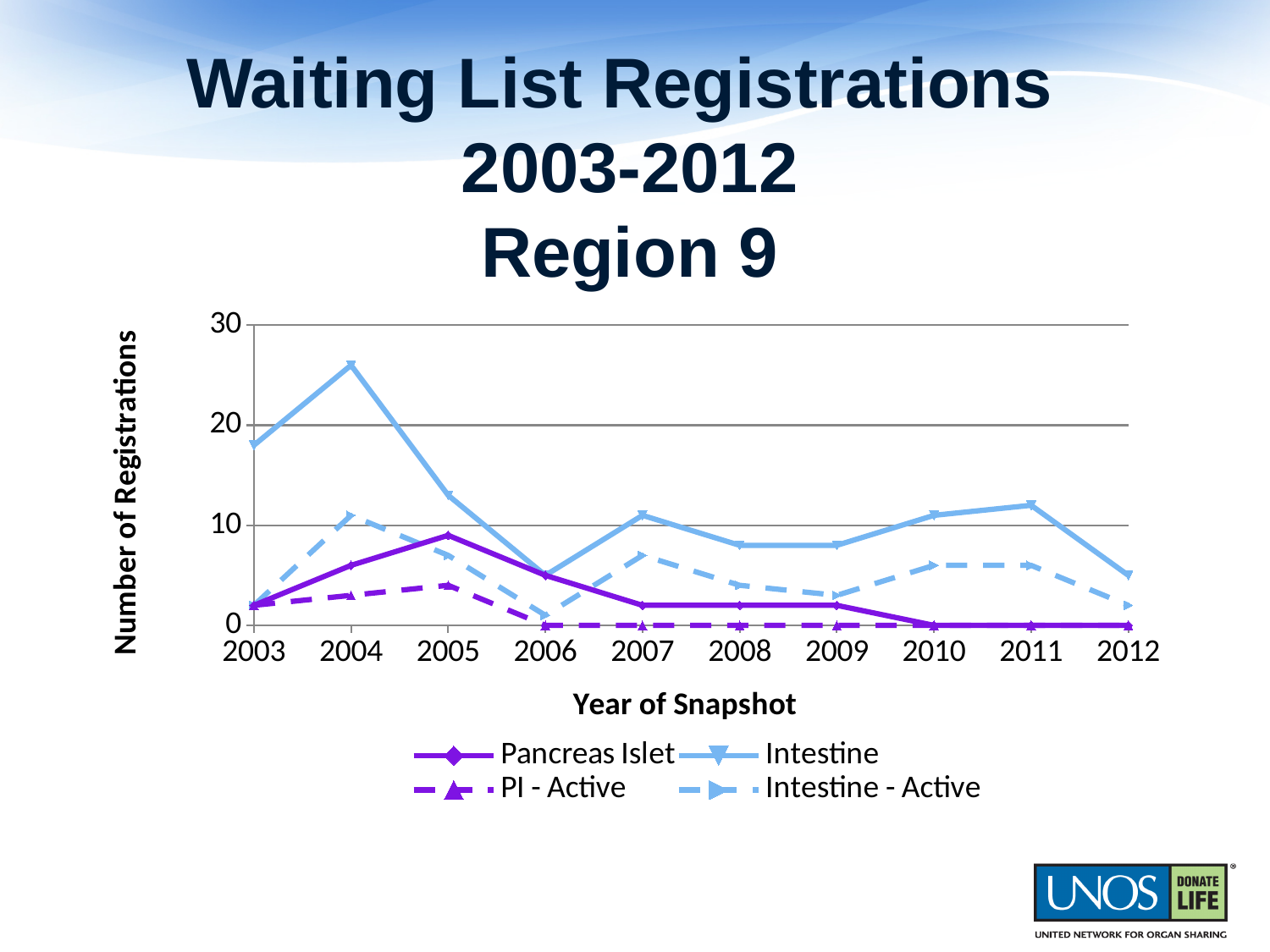
Is the value for Intestine in 2004 greater or less than 20? greater What is the label of the y axis? Number of Registrations Is the value for Intestine in 2006 greater or less than 10? less What kind of chart is shown on the slide? line chart In which year does the Pancreas Islet series reach its highest value? 2005 In which year does the Intestine series reach its highest value? 2004 Which is larger in 2004, the value for Intestine or the value for Pancreas Islet? Intestine How many series does the legend list? 4 Is the value for Pancreas Islet in 2005 greater or less than 10? less What is the value for PI - Active in 2008? 0 How many years are plotted along the x axis? 10 What is the value for Pancreas Islet in 2012? 0